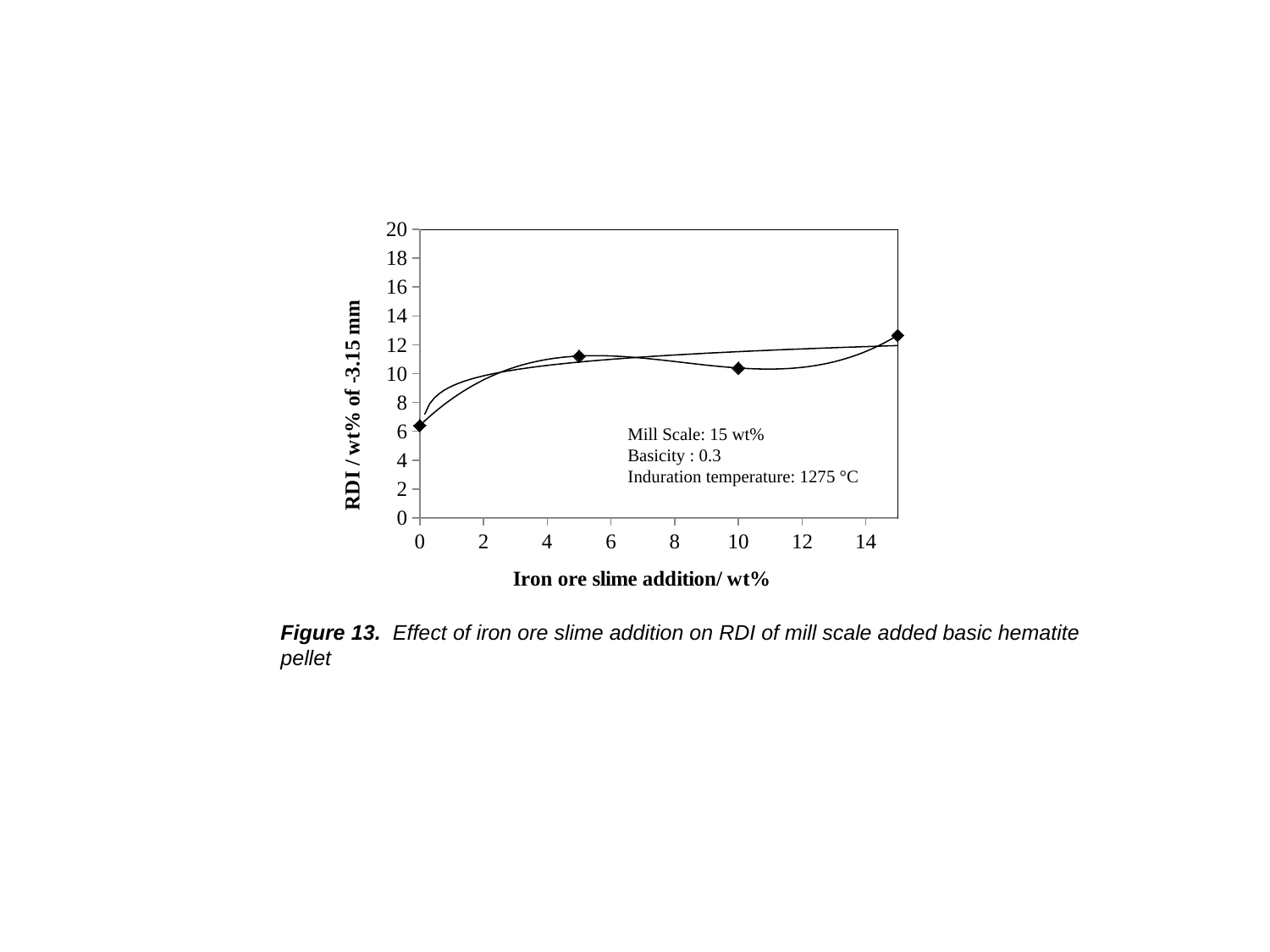
Which has the larger RDI value: 0 wt% or 15 wt% iron ore slime addition? 15 wt% How many data points are plotted on the chart? 4 Is the RDI value at 5 wt% iron ore slime addition greater or less than 10? greater At which iron ore slime addition is the RDI lowest? 0 wt% Is the RDI value at 15 wt% iron ore slime addition greater or less than 14? less At which iron ore slime addition is the RDI highest? 15 wt% What induration temperature is stated in the annotation on the chart? 1275 °C Is the RDI value at 0 wt% iron ore slime addition greater or less than 8? less What is the label of the x axis? Iron ore slime addition/ wt% Overall, does the RDI rise or fall as iron ore slime addition increases from 0 to 15 wt%? rise What kind of chart is shown on the slide? line chart